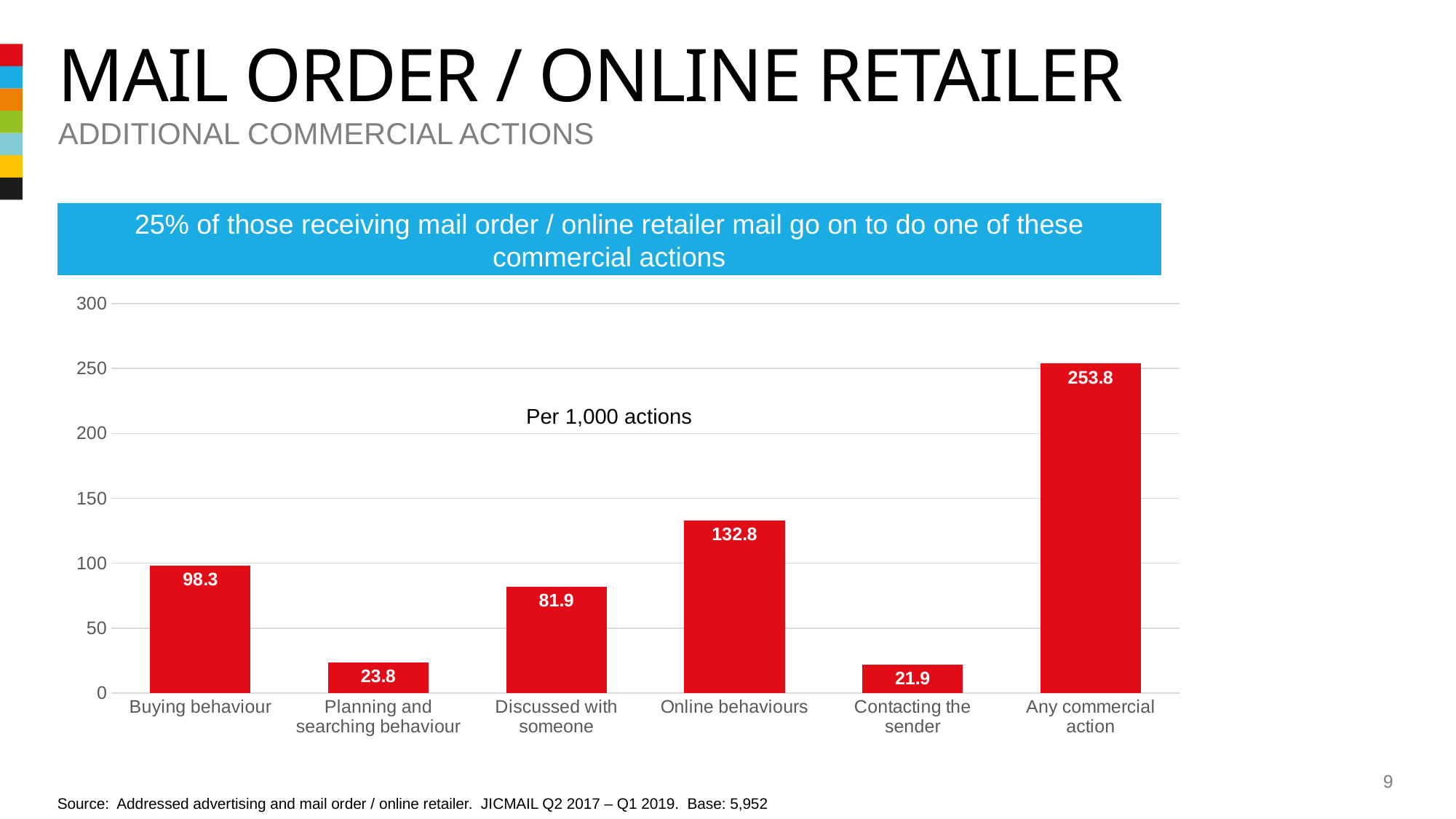
What is the value for Contacting the sender? 21.9 Which category has the highest value? Any commercial action Is the value for Discussed with someone greater or less than 100? less What is the value for Buying behaviour? 98.3 What kind of chart is shown on the slide? bar chart What is the value for Any commercial action? 253.8 What is the difference between Online behaviours and Buying behaviour? 34.5 How many categories are shown on the chart? 6 What is the value for Online behaviours? 132.8 Which is larger, Discussed with someone or Buying behaviour? Buying behaviour What unit label is shown on the chart? Per 1,000 actions Which category has the lowest value? Contacting the sender